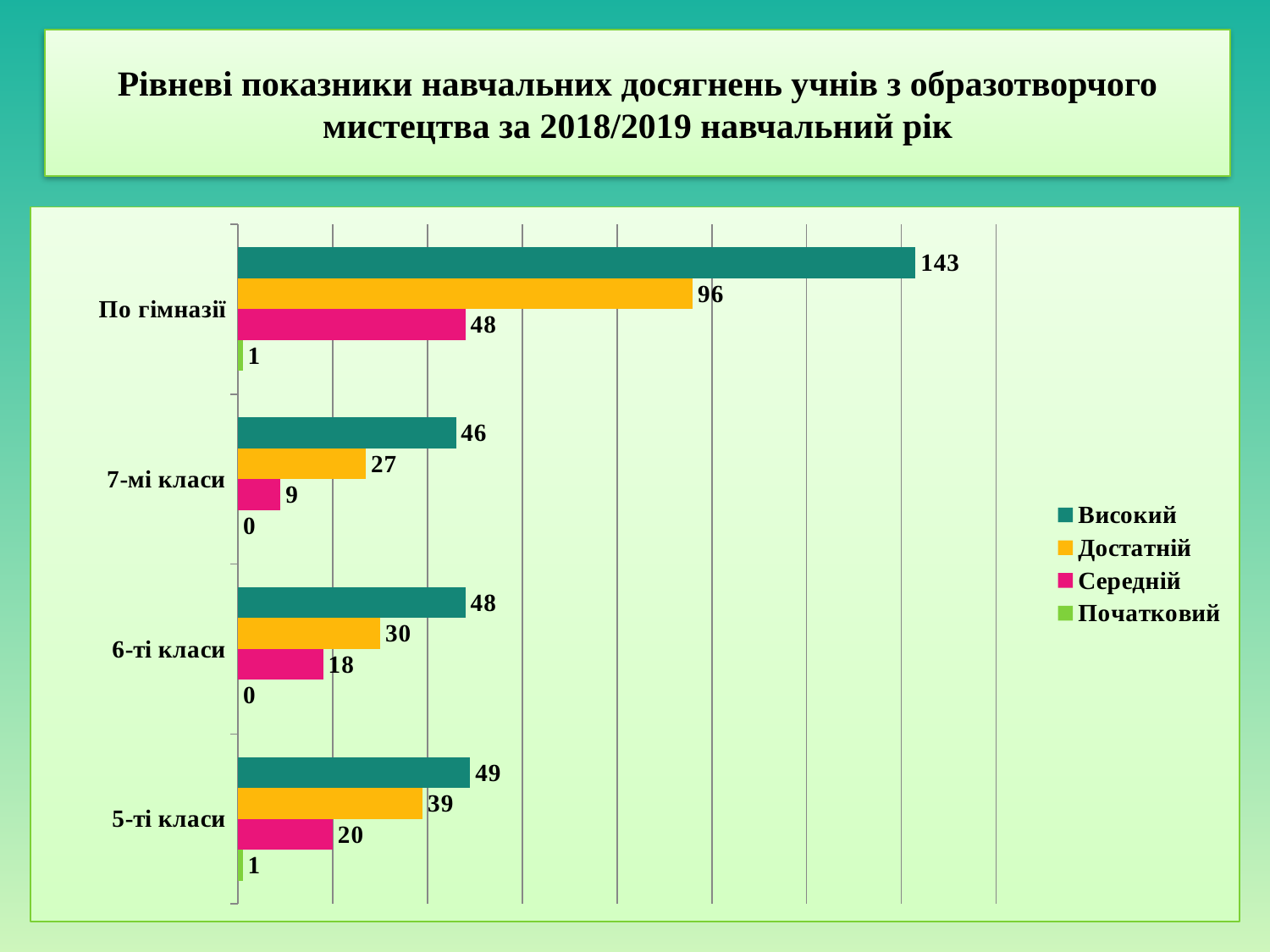
What is the value of Середній for 7-мі класи? 9 What is the value of Початковий for 6-ті класи? 0 How many series does the legend list? 4 Which series is shown in pink on the chart? Середній What kind of chart is shown on the slide? Bar chart What is the value of Високий for По гімназії? 143 Which category has the highest Достатній value? По гімназії Which is larger: the Середній value for 5-ті класи or for 6-ті класи? 5-ті класи Among 5-ті класи, 6-ті класи and 7-мі класи, which has the lowest Середній value? 7-мі класи What is the difference between the Високий and Достатній values for По гімназії? 47 How many categories are shown on the chart? 4 What is the value of Достатній for 5-ті класи? 39